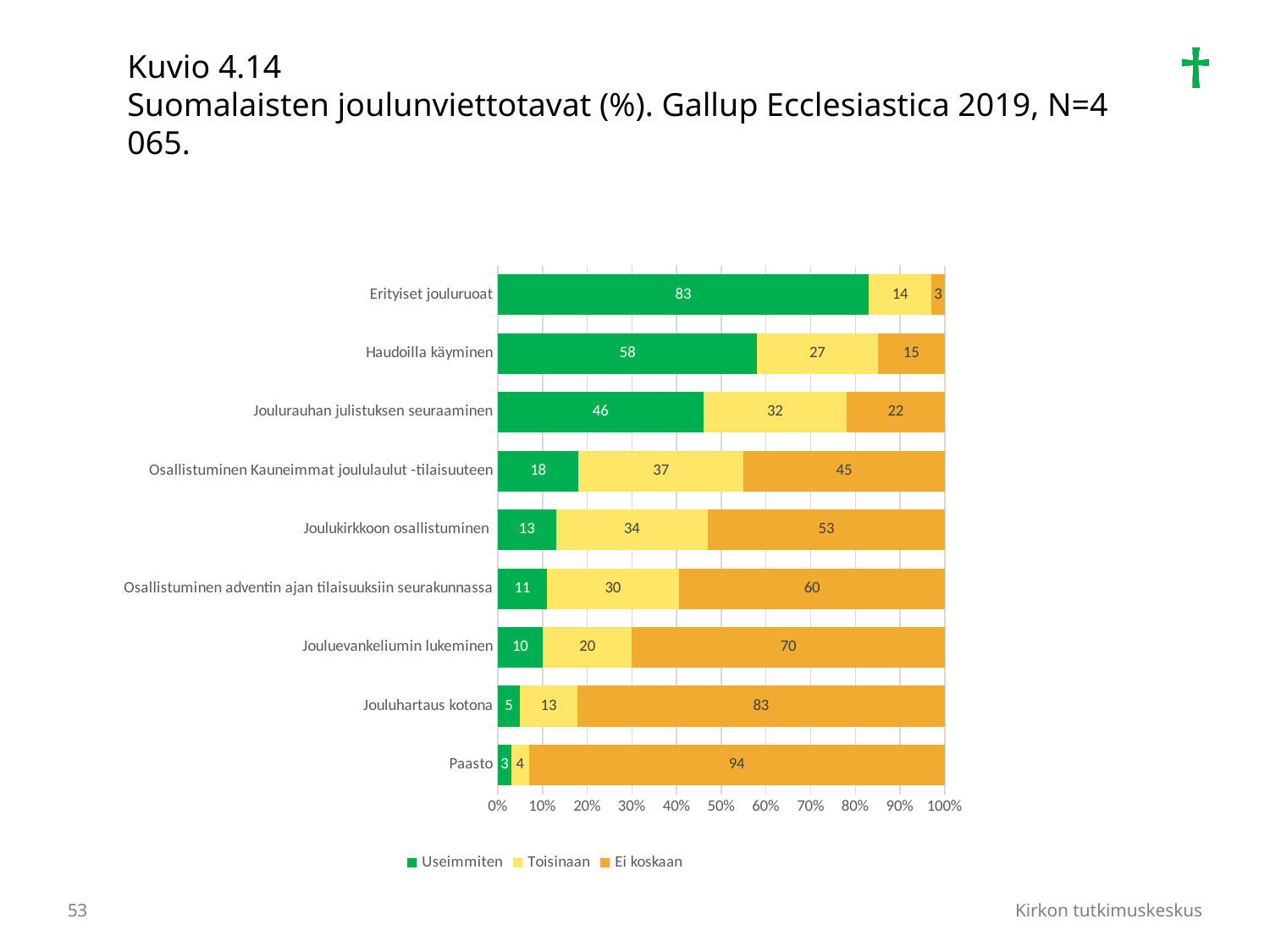
What kind of chart is shown on the slide? Stacked bar chart What is the total of the stacked bar for Haudoilla käyminen? 100 Which is larger: the 'Toisinaan' value for Joulukirkkoon osallistuminen or for Osallistuminen adventin ajan tilaisuuksiin seurakunnassa? Joulukirkkoon osallistuminen What is the 'Toisinaan' value for Osallistuminen Kauneimmat joululaulut -tilaisuuteen? 37 What is the difference between the 'Useimmiten' values for Haudoilla käyminen and Joulurauhan julistuksen seuraaminen? 12 What is the 'Ei koskaan' value for Paasto? 94 How many series does the legend list? 3 Which category has the highest 'Useimmiten' value? Erityiset jouluruoat What is the 'Ei koskaan' value for Jouluevankeliumin lukeminen? 70 Which category has the lowest 'Ei koskaan' value? Erityiset jouluruoat What is the 'Useimmiten' value for Erityiset jouluruoat? 83 How many categories are shown on the chart? 9